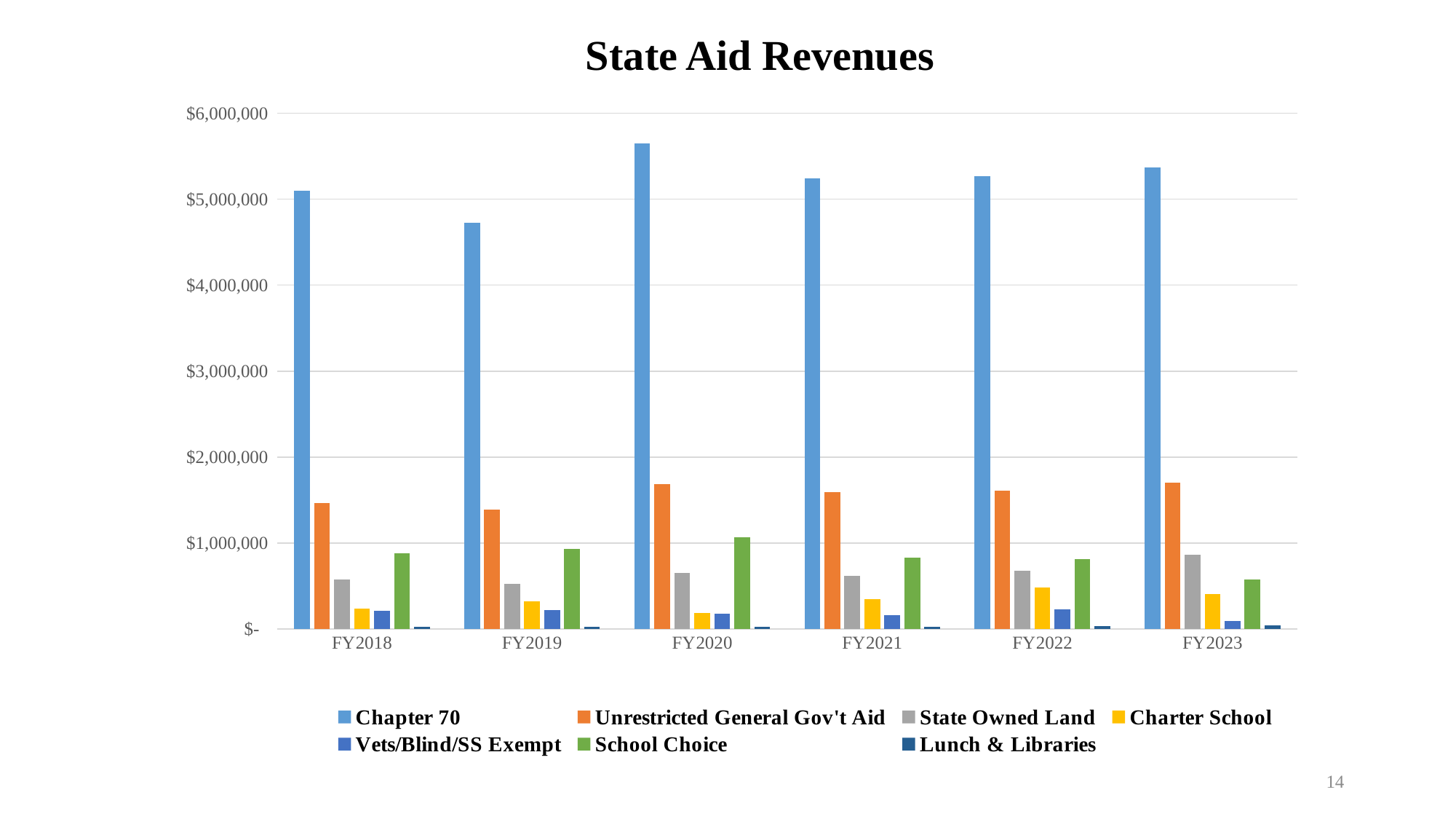
In which fiscal year is the Chapter 70 value highest? FY2020 Which series has the largest value in every fiscal year? Chapter 70 Is the Unrestricted General Gov't Aid value for FY2023 greater or less than $2,000,000? less What is the title of the chart? State Aid Revenues In FY2018, which is larger: Unrestricted General Gov't Aid or School Choice? Unrestricted General Gov't Aid In which fiscal year is the Chapter 70 value lowest? FY2019 What kind of chart is shown on the slide? Bar chart How many series does the legend list? 7 In FY2023, which is larger: State Owned Land or School Choice? State Owned Land Which series has the smallest value in every fiscal year? Lunch & Libraries Is the Chapter 70 value for FY2019 greater or less than $5,000,000? less How many fiscal years are shown on the x axis? 6